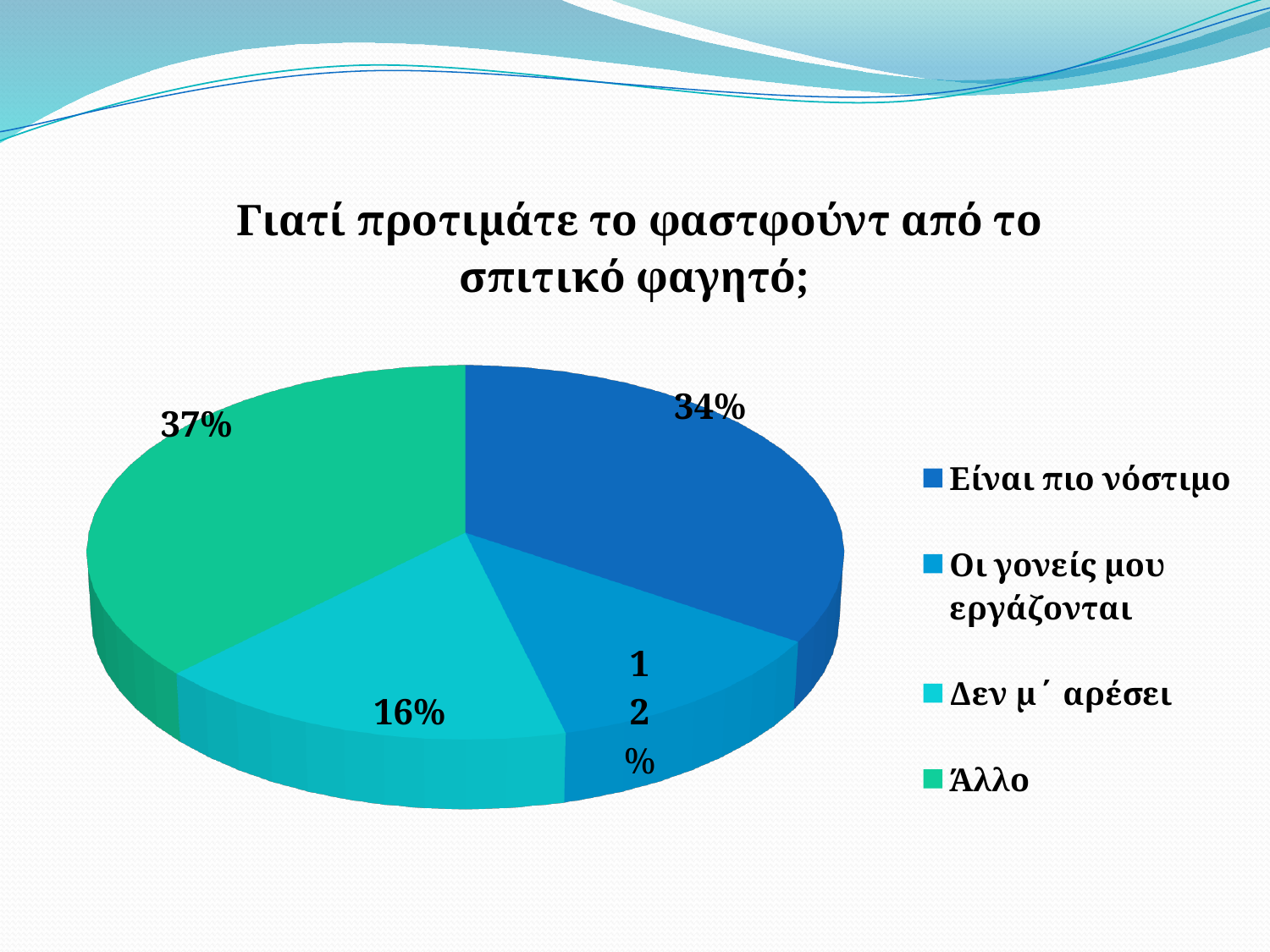
How many entries does the legend list? 4 What percentage is shown for the slice 'Είναι πιο νόστιμο'? 34% What percentage is shown for the slice 'Δεν μ΄ αρέσει'? 16% Which slice has the smallest share of the pie? Οι γονείς μου εργάζονται How many slices does the pie chart have? 4 What is the title of the chart? Γιατί προτιμάτε το φαστφούντ από το σπιτικό φαγητό; Which is larger, the share for 'Δεν μ΄ αρέσει' or the share for 'Οι γονείς μου εργάζονται'? Δεν μ΄ αρέσει What percentage is shown for the slice 'Άλλο'? 37% What kind of chart is shown on the slide? Pie chart Which slice has the largest share of the pie? Άλλο What is the difference in percentage points between 'Άλλο' and 'Είναι πιο νόστιμο'? 3 What percentage is shown for the slice 'Οι γονείς μου εργάζονται'? 12%